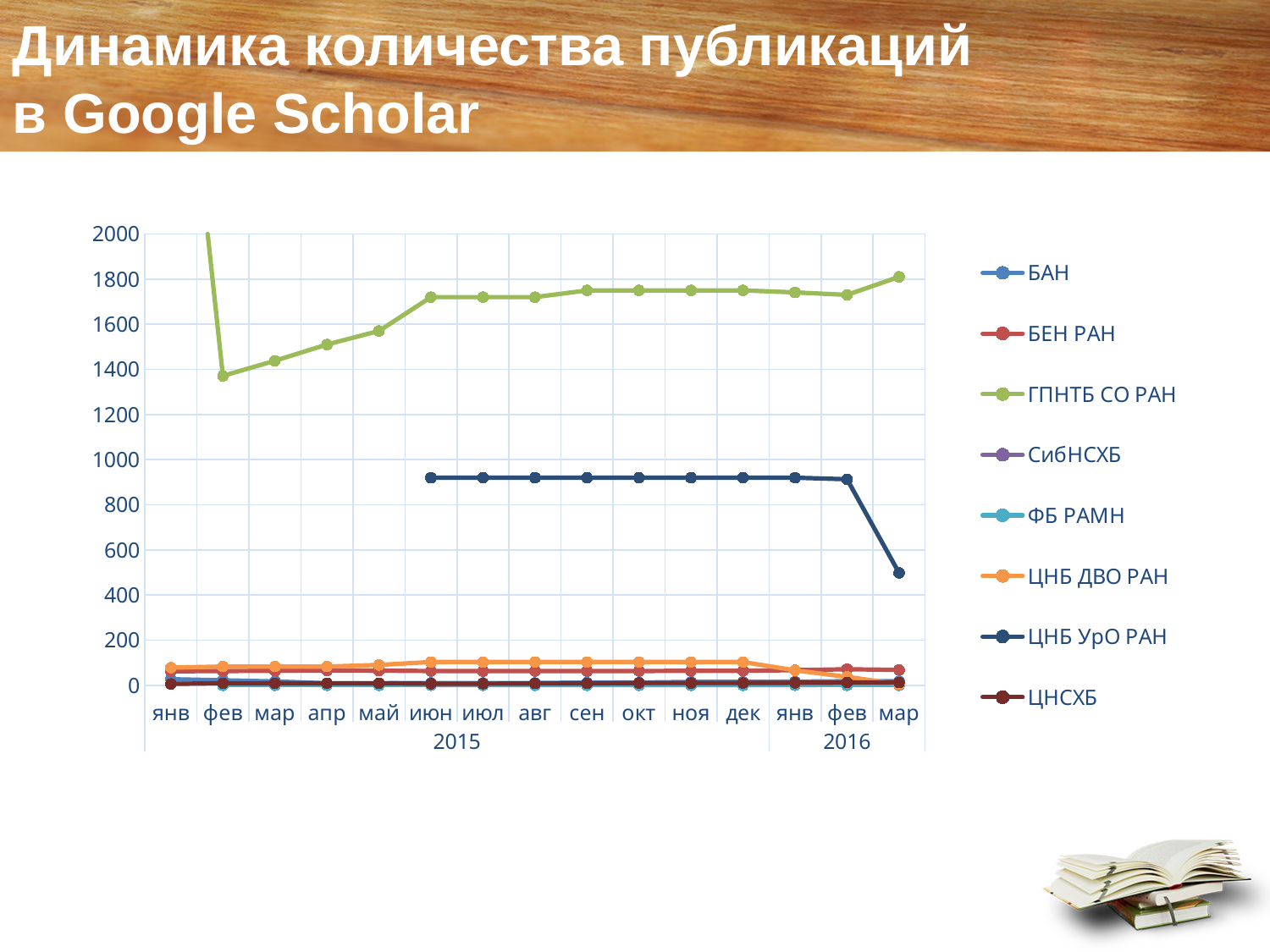
Is the value for ЦНБ УрО РАН in June 2015 greater or less than 1000? less Is the value for ГПНТБ СО РАН in February 2015 greater or less than 1600? less What kind of chart is shown on the slide? line chart Is the value for ЦНБ УрО РАН in March 2016 greater or less than 600? less Does the ЦНБ УрО РАН line rise or fall between February 2016 and March 2016? fall Which is larger in October 2015: the value for ГПНТБ СО РАН or the value for ЦНБ УрО РАН? ГПНТБ СО РАН Which series has the highest values throughout the chart? ГПНТБ СО РАН Does the ГПНТБ СО РАН line generally rise or fall from February 2015 to March 2016? rise How many months (data points) are shown along the x axis? 15 How many series does the legend list? 8 What is the title of the slide? Динамика количества публикаций в Google Scholar